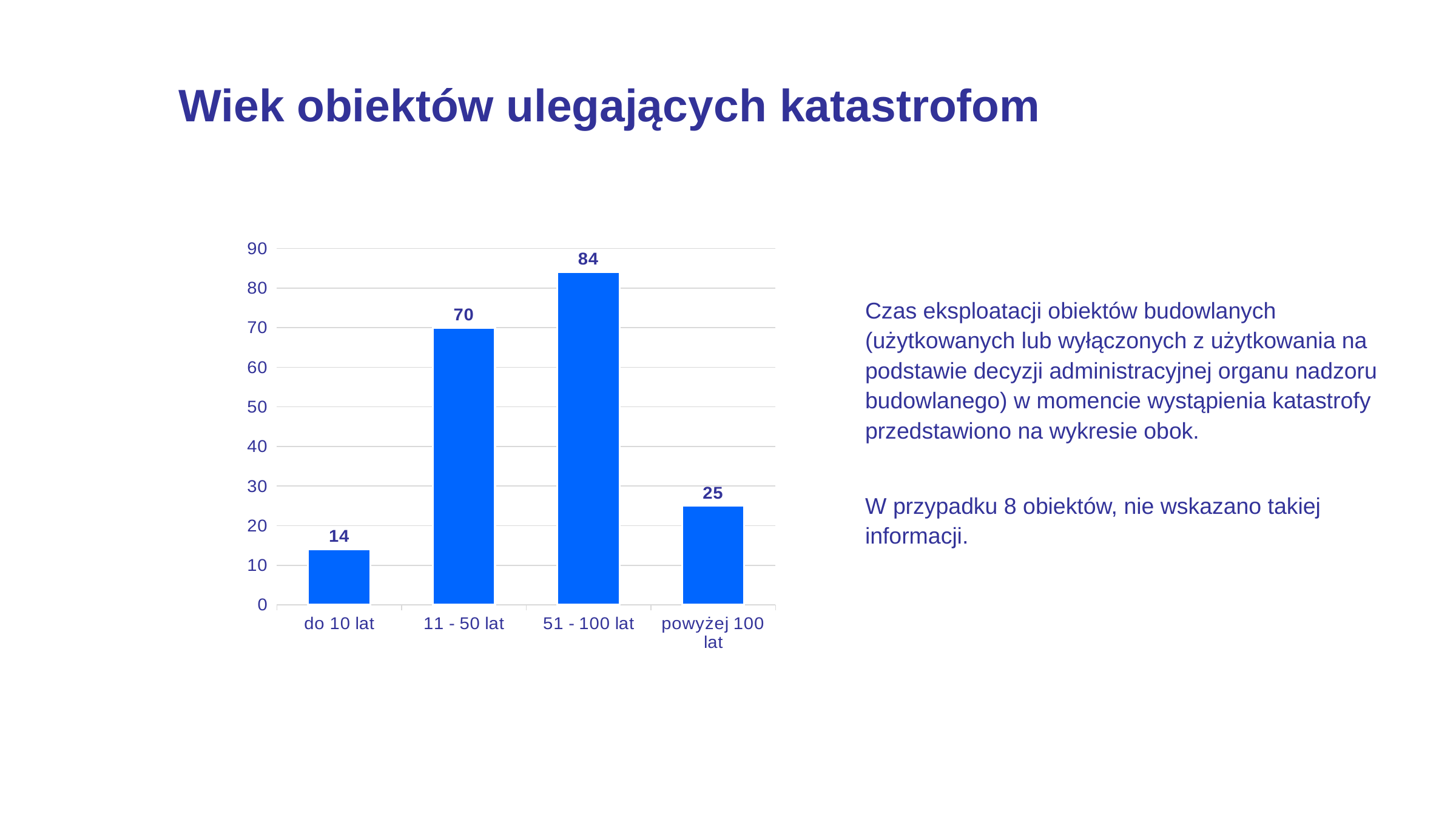
What kind of chart is shown on the slide? bar chart Is the value for '11 - 50 lat' greater or less than 60? greater Which category has the lowest value? do 10 lat What is the title of the slide containing the chart? Wiek obiektów ulegających katastrofom Which is larger, the value for 'powyżej 100 lat' or the value for 'do 10 lat'? powyżej 100 lat How many categories are shown on the x axis? 4 What is the value for the category 'powyżej 100 lat'? 25 What is the difference between the values for '51 - 100 lat' and '11 - 50 lat'? 14 What is the value for the category '51 - 100 lat'? 84 What is the value for the category 'do 10 lat'? 14 Which category has the highest value? 51 - 100 lat What is the value for the category '11 - 50 lat'? 70